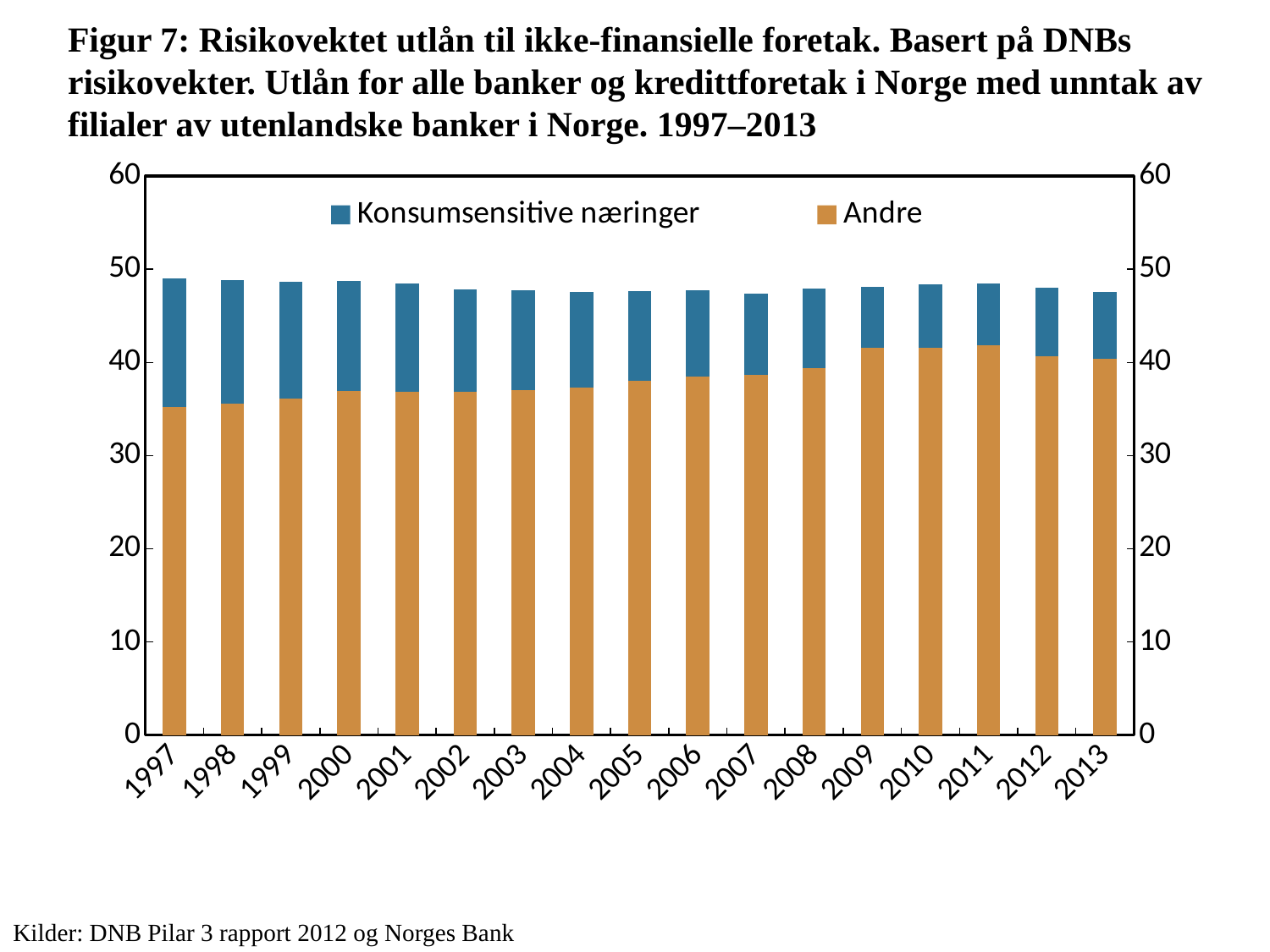
Which is larger, the Andre value in 1997 or the Andre value in 2013? 2013 Is the value for Andre in 1997 greater or less than 40? less Is the value for Andre in 2005 greater or less than 40? less Which colour represents Andre in the legend? Orange What kind of chart is shown on the slide? Stacked bar chart Is the value for Andre in 2011 greater or less than 40? greater How many years (categories) are shown on the x axis? 17 Which is larger, the Konsumsensitive næringer segment in 1997 or in 2013? 1997 How many series does the legend list? 2 Does the Andre series generally rise or fall from 1997 to 2011? rise